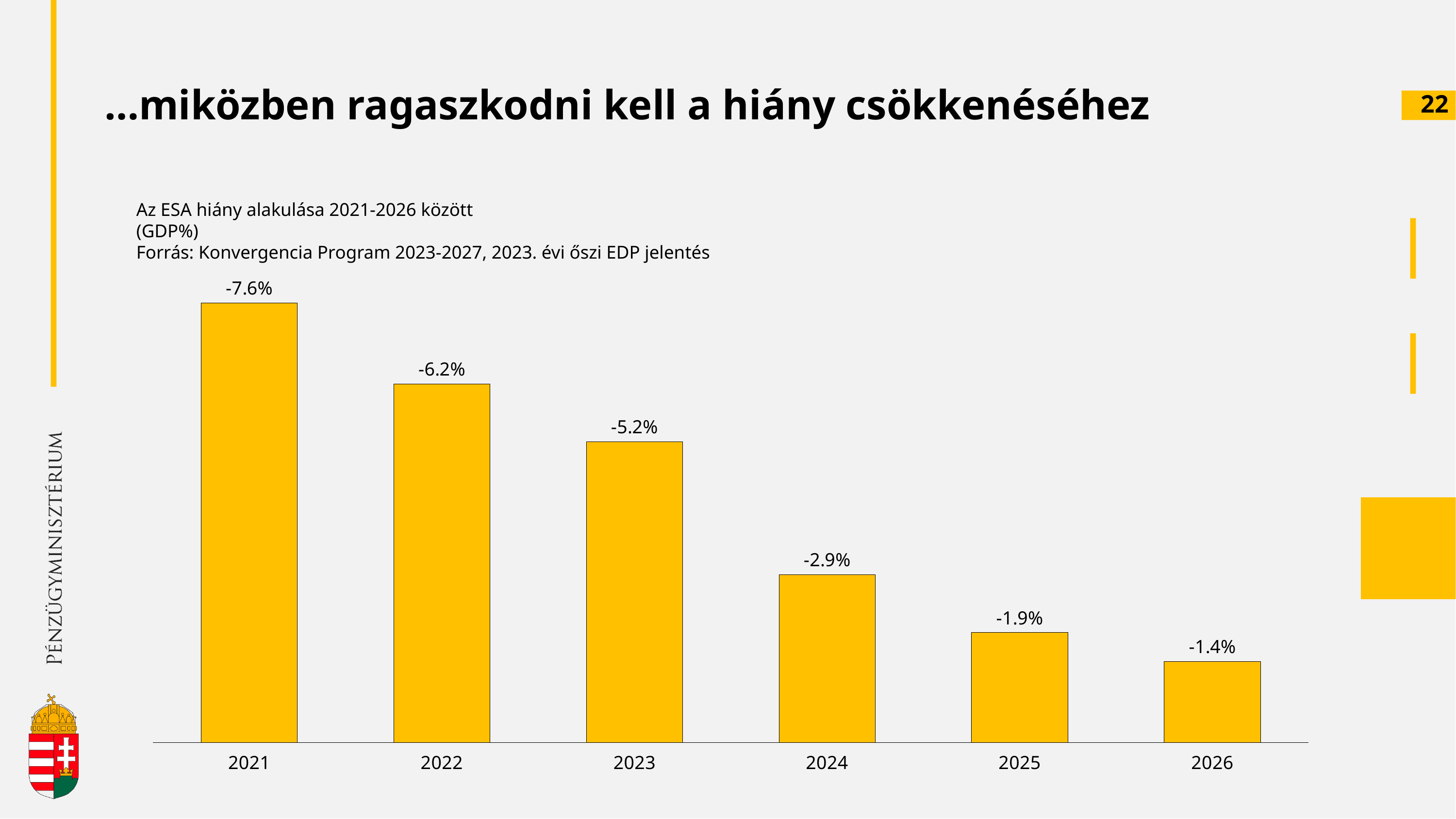
Do the bars get taller or shorter from 2021 to 2026? Shorter What is the ESA deficit value shown for 2024? -2.9% By how many percentage points does the deficit magnitude differ between 2021 (-7.6%) and 2022 (-6.2%)? 1.4 percentage points Which year has the shortest bar, i.e. the smallest deficit? 2026 What is the ESA deficit value shown for 2021? -7.6% Which year has the tallest bar, i.e. the largest deficit? 2021 Which year has the taller bar, 2023 or 2025? 2023 What is the ESA deficit value shown for 2026? -1.4% What is the ESA deficit value shown for 2023? -5.2% How many years (bars) are shown in the chart? 6 By how many percentage points does the deficit magnitude differ between 2024 (-2.9%) and 2026 (-1.4%)? 1.5 percentage points What kind of chart is shown on the slide? Bar chart